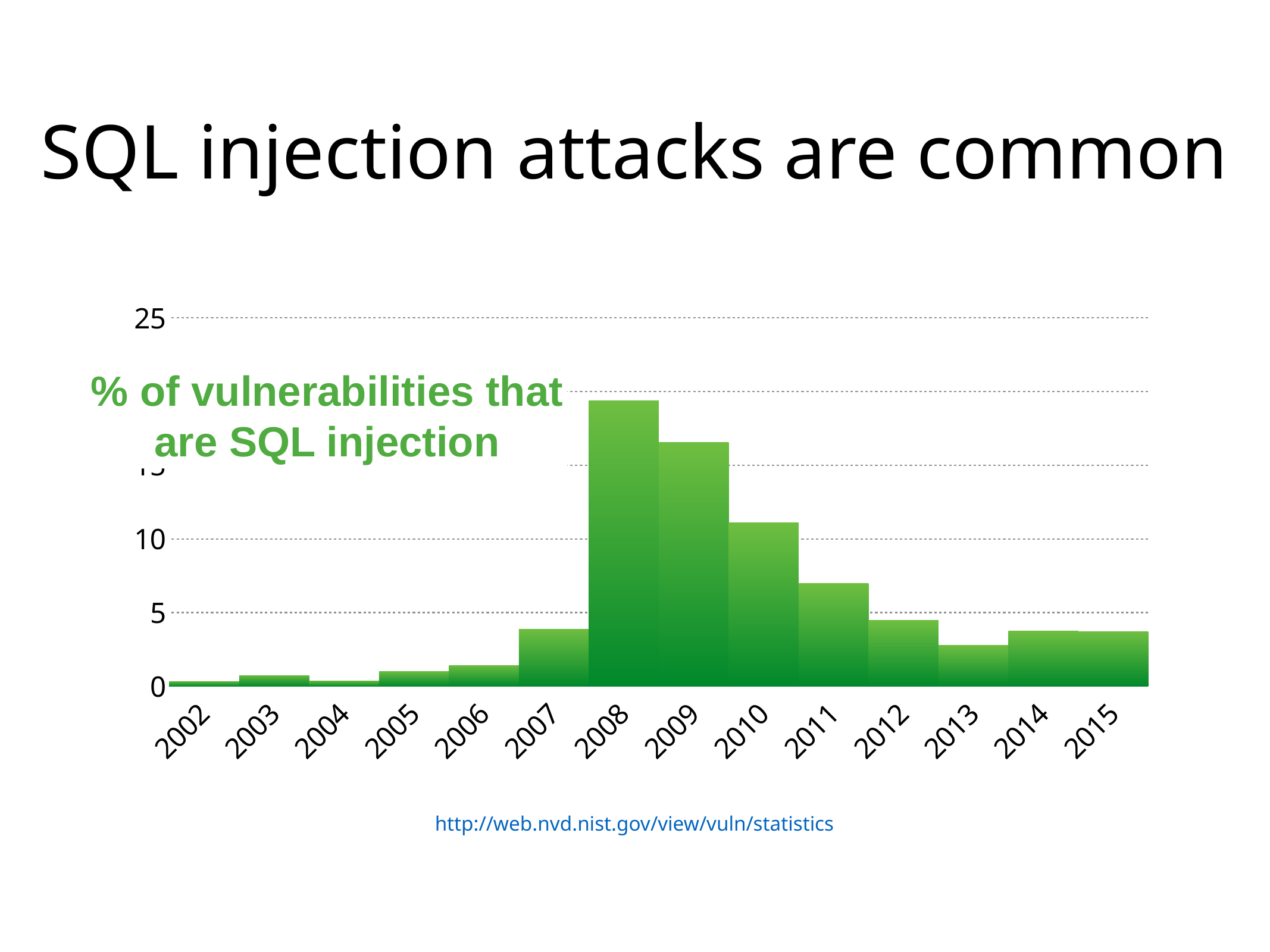
Is the value for 2011 greater or less than 5? greater Do the values rise or fall from 2004 to 2008? rise Is the value for 2008 greater or less than 15? greater How many years are shown on the x axis of the chart? 14 What does the green label on the chart say the bars represent? % of vulnerabilities that are SQL injection Is the value for 2010 greater or less than 10? greater Do the values rise or fall from 2008 to 2013? fall What kind of chart is shown on the slide? bar chart Which year has the larger value, 2008 or 2009? 2008 Which year has the highest percentage of vulnerabilities that are SQL injection? 2008 Which year has the larger value, 2010 or 2011? 2010